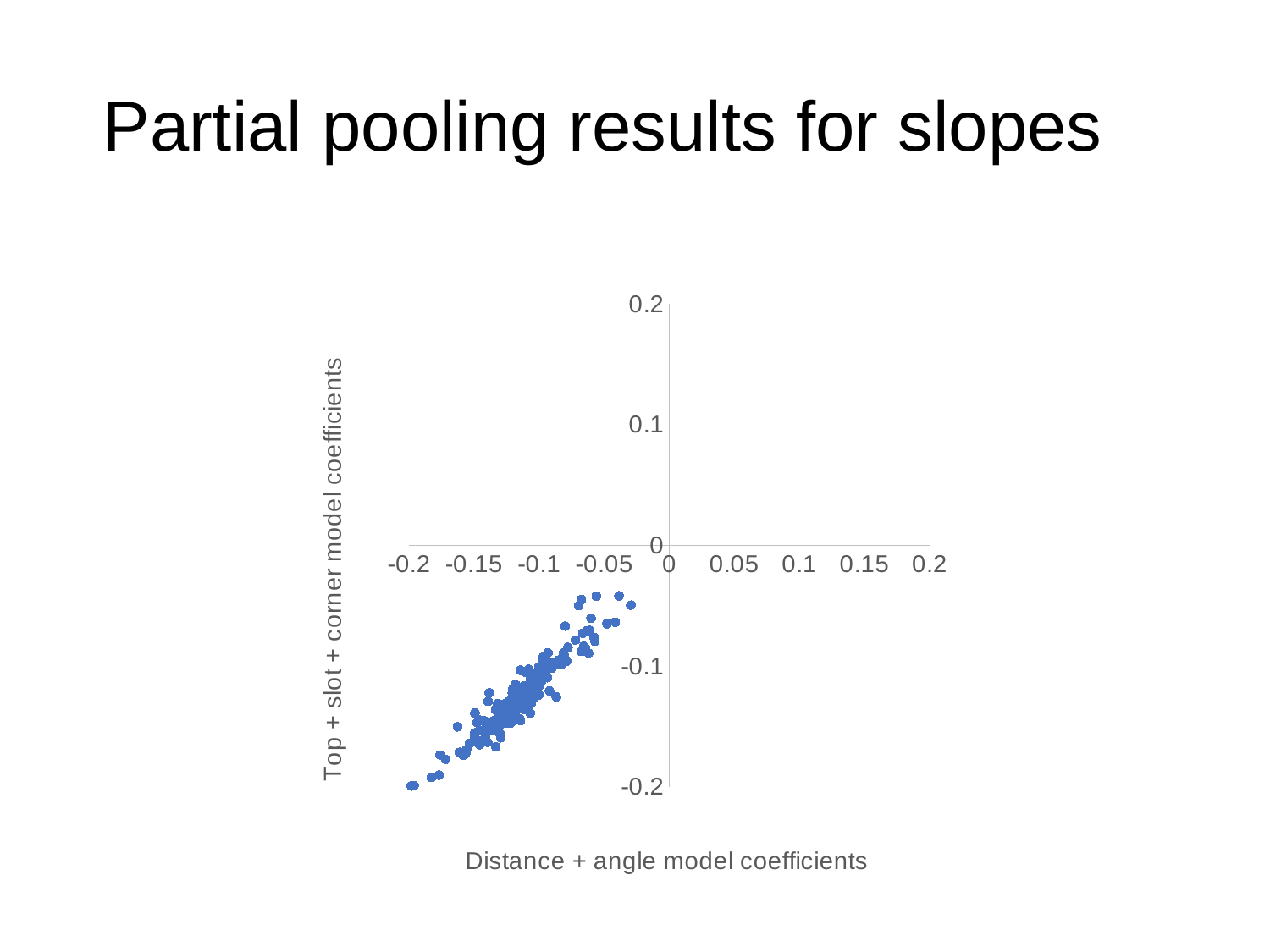
What is the title of the x axis of the chart? Distance + angle model coefficients As the x values of the plotted points increase, do the y values rise or fall? Rise Are the y values of the highest plotted points greater or less than -0.1? greater What is the lowest value labelled on the x axis? -0.2 Are the x values of the plotted points greater or less than 0? less What kind of chart is shown on the slide? Scatter plot How many tick labels are shown on the x axis? 9 Is the x value of the lowest plotted point greater or less than -0.15? less What is the highest value labelled on the y axis? 0.2 What is the title of the y axis of the chart? Top + slot + corner model coefficients